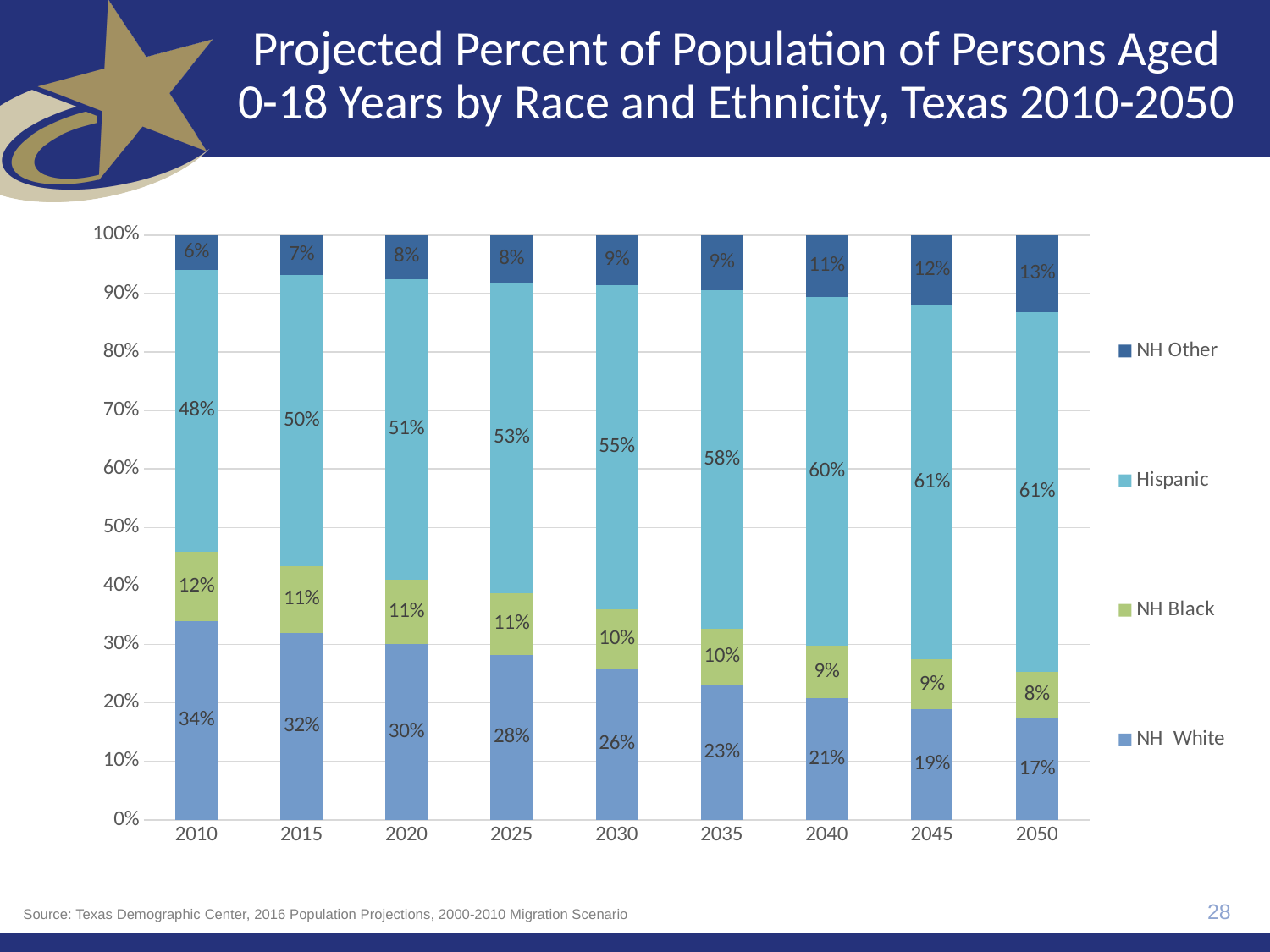
In which year is the NH White share highest? 2010 What is the NH White value for 2050? 17% In which year is the NH Other share lowest? 2010 What is the NH Black value for 2025? 11% How many series does the legend list? 4 What is the Hispanic share of the population aged 0-18 in 2030? 55% What is the NH Other value for 2010? 6% What kind of chart is shown on the slide? Stacked bar chart Does the NH White share rise or fall from 2010 to 2050? Fall How many years are shown on the x axis? 9 Which is larger in 2040, the Hispanic value or the NH White value? Hispanic What is the difference between the NH White values for 2010 and 2050? 17%